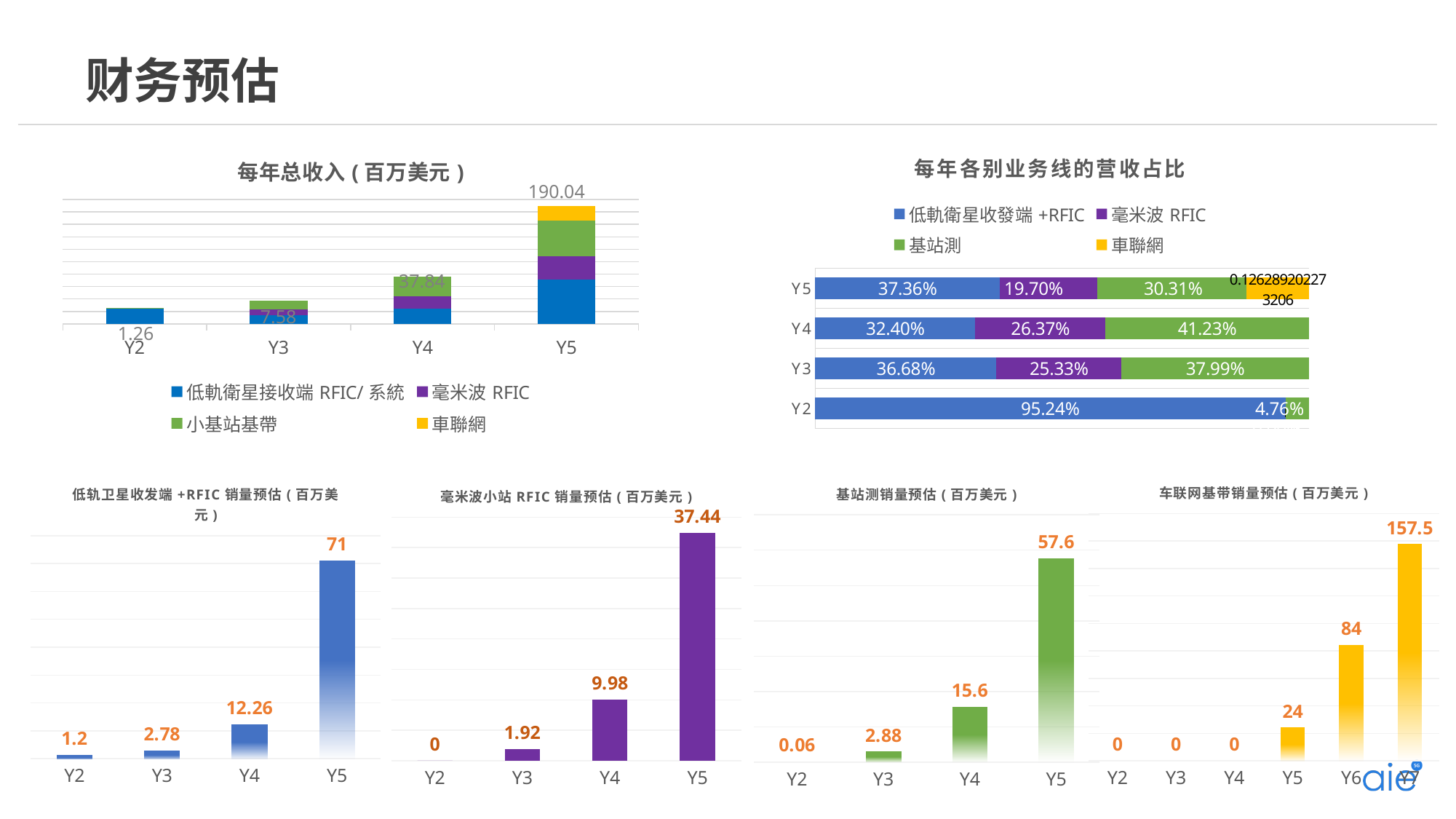
In the chart titled 每年总收入（百万美元）, how many series does the legend list? 4 In the chart titled 车联网基带销量预估（百万美元）, do the values rise or fall from Y5 to Y7? rise In the chart titled 每年各别业务线的营收占比, what share does 基站測 have in Y4? 41.23% In the chart titled 毫米波小站 RFIC 销量预估（百万美元）, what is the value for Y5? 37.44 In the chart titled 每年总收入（百万美元）, what is the total revenue for Y3? 7.58 In the chart titled 低轨卫星收发端 +RFIC 销量预估（百万美元）, what is the value for Y4? 12.26 In the chart titled 基站测销量预估（百万美元）, which year has the lowest value? Y2 In the chart titled 车联网基带销量预估（百万美元）, how many years are shown on the x axis? 6 In the chart titled 每年各别业务线的营收占比, which year has the highest share for 毫米波 RFIC? Y4 In the chart titled 每年各别业务线的营收占比, what share does 低軌衛星收發端 +RFIC have in Y2? 95.24% In the chart titled 低轨卫星收发端 +RFIC 销量预估（百万美元）, what is the difference between Y5 and Y4? 58.74 In the chart titled 每年总收入（百万美元）, what is the total revenue for Y5? 190.04